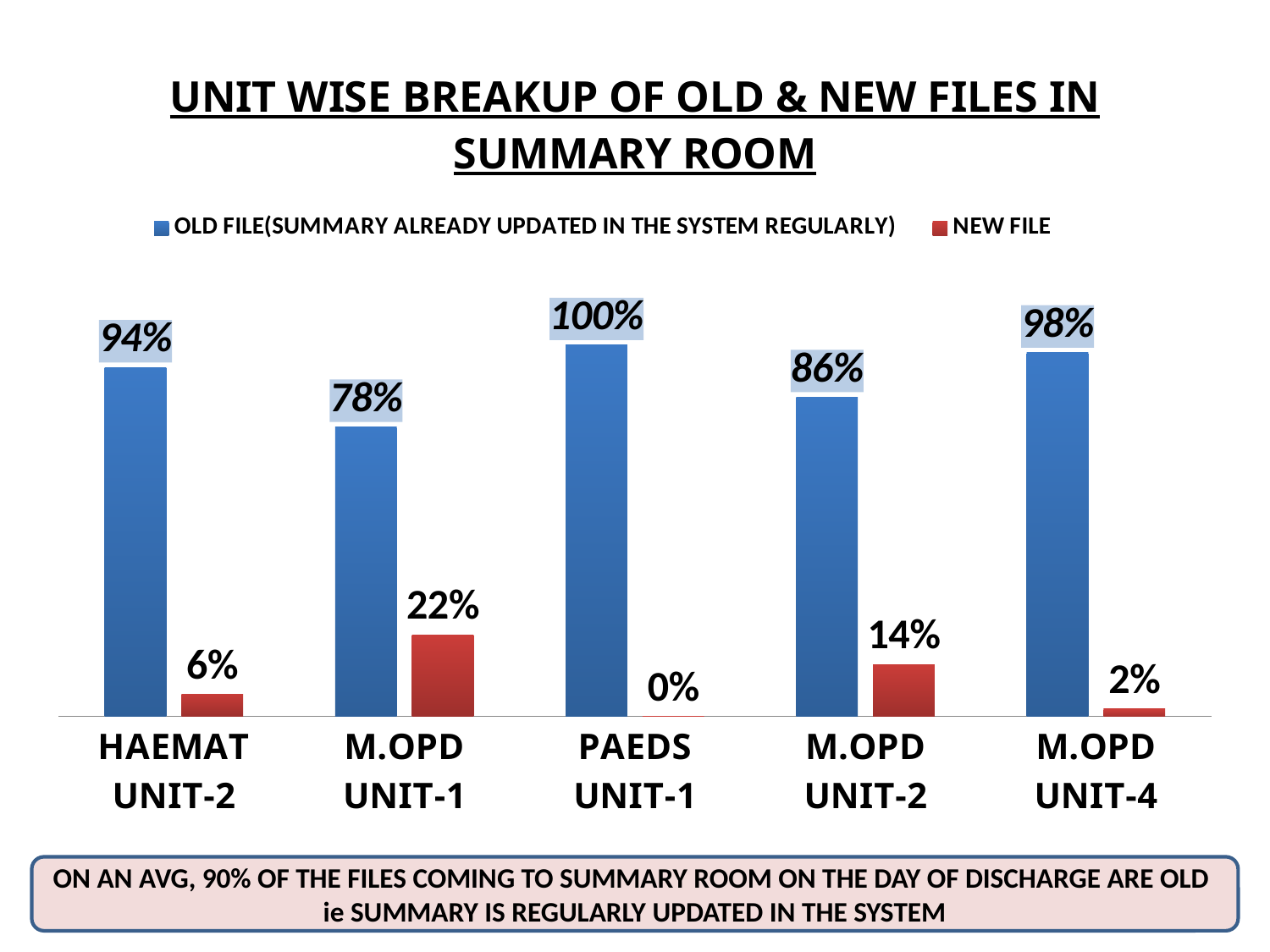
Which is larger, the NEW FILE value for HAEMAT UNIT-2 or for M.OPD UNIT-2? M.OPD UNIT-2 How many units are shown on the x axis? 5 Which unit has the highest NEW FILE value? M.OPD UNIT-1 What is the NEW FILE value for M.OPD UNIT-1? 22% What colour represents the NEW FILE series? Red What is the OLD FILE value for M.OPD UNIT-2? 86% How many series does the legend list? 2 What is the OLD FILE value for PAEDS UNIT-1? 100% What kind of chart is shown on the slide? Bar chart Which unit has the lowest OLD FILE value? M.OPD UNIT-1 What is the NEW FILE value for M.OPD UNIT-4? 2% What is the difference between the OLD FILE values for HAEMAT UNIT-2 and M.OPD UNIT-2? 8%